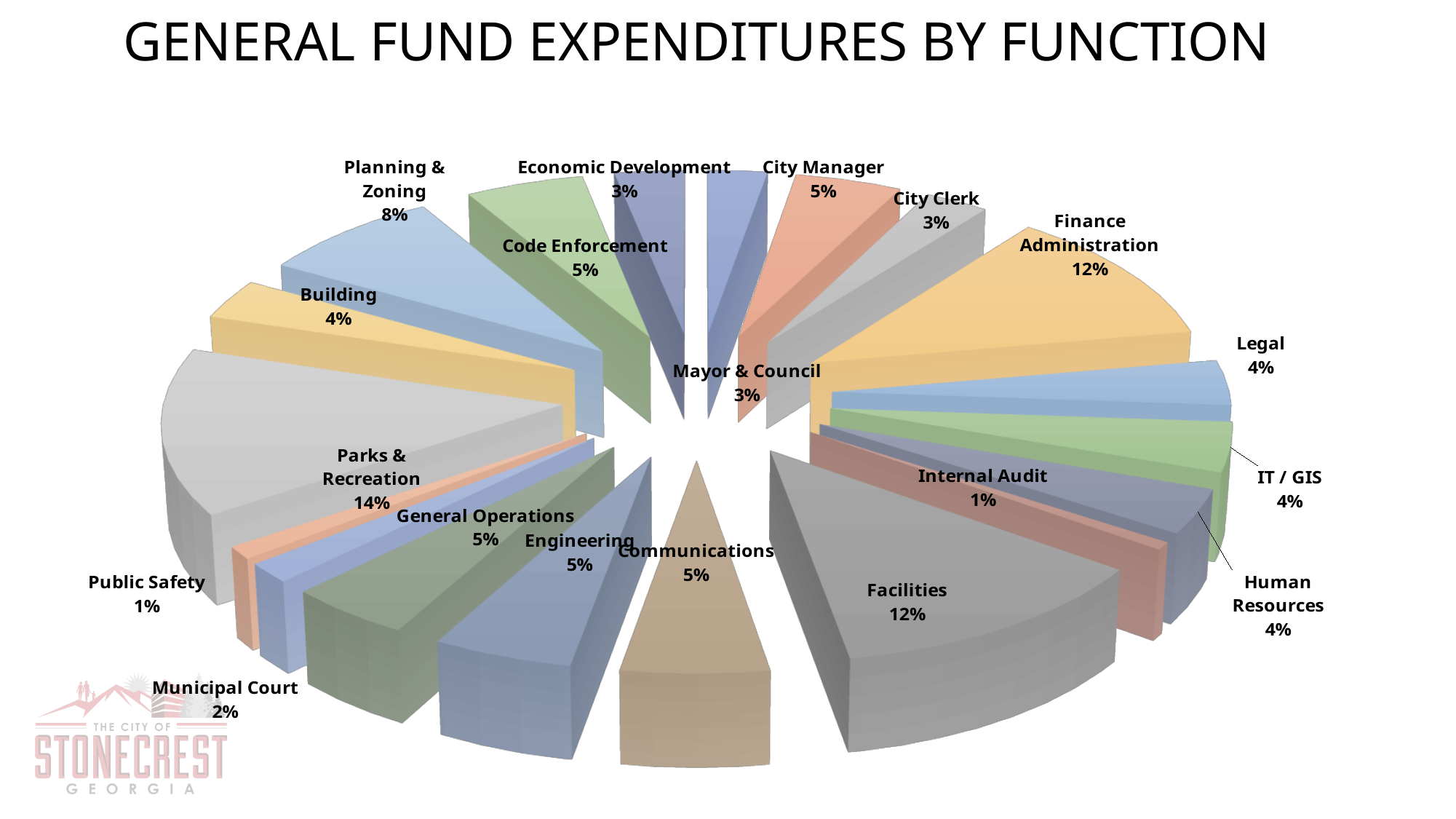
What share is shown for Internal Audit? 1% What is the difference between the Parks & Recreation share and the Facilities share? 2% What is the difference between the Planning & Zoning share and the Building share? 4% Which is larger, the share for Planning & Zoning or the share for City Manager? Planning & Zoning What percentage is shown for Finance Administration? 12% What kind of chart is shown on the slide? Pie chart What is the value for Planning & Zoning? 8% Which function has the largest share of general fund expenditures? Parks & Recreation How many functions (slices) are shown in the chart? 19 What share of general fund expenditures goes to Parks & Recreation? 14% Which is larger, the share for Facilities or the share for Communications? Facilities What percentage of expenditures is allocated to Municipal Court? 2%